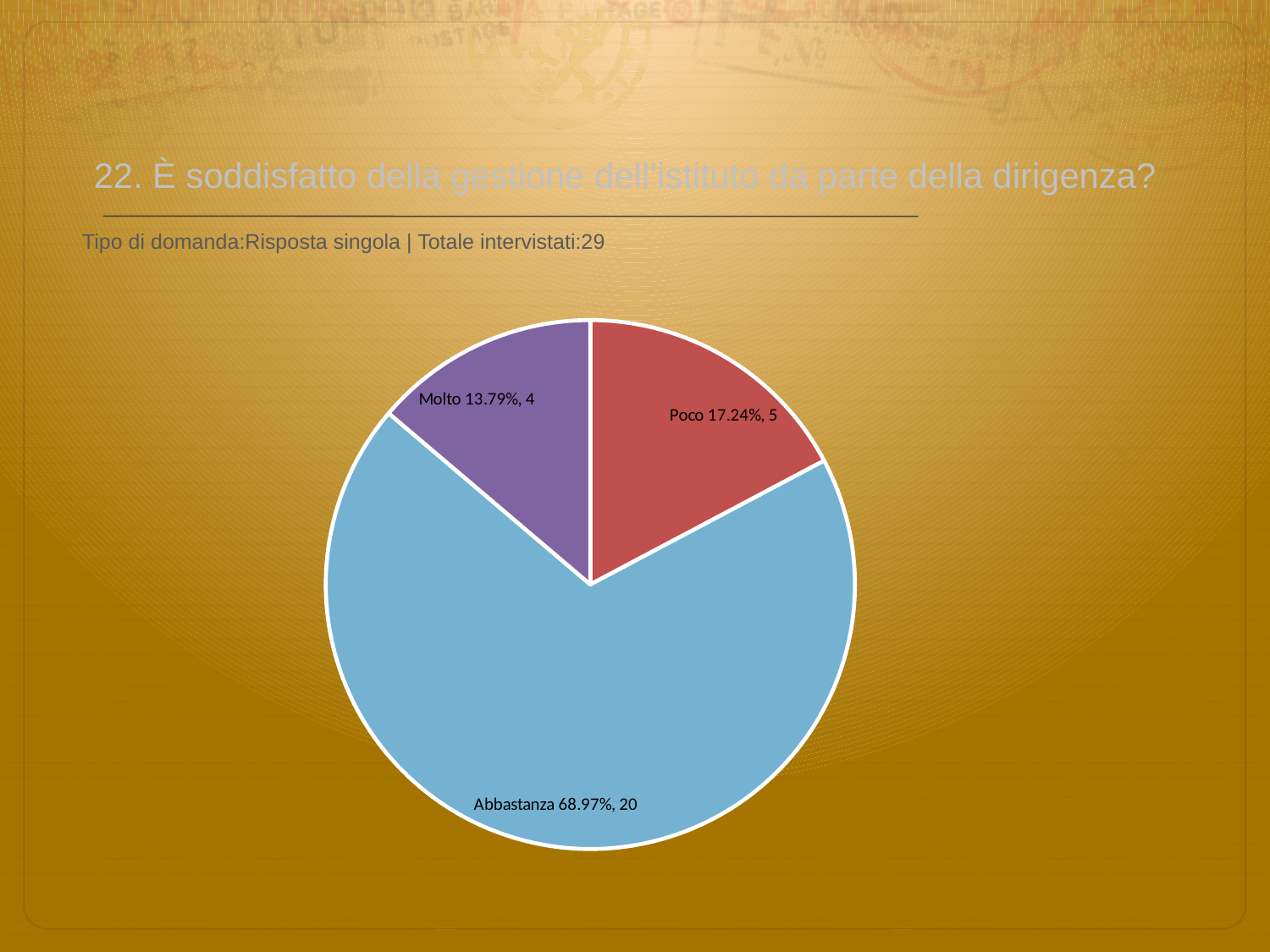
What colour is the Abbastanza slice? light blue How many respondents answered Molto? 4 What percentage share does the Molto slice have? 13.79% How many slices does the pie chart have? 3 What percentage share does the Poco slice have? 17.24% How many respondents answered Poco? 5 Which category has the largest slice? Abbastanza How many respondents answered Abbastanza? 20 What percentage share does the Abbastanza slice have? 68.97% What is the difference in respondent count between Abbastanza and Poco? 15 What kind of chart is shown on the slide? pie chart Which category has the smallest slice? Molto